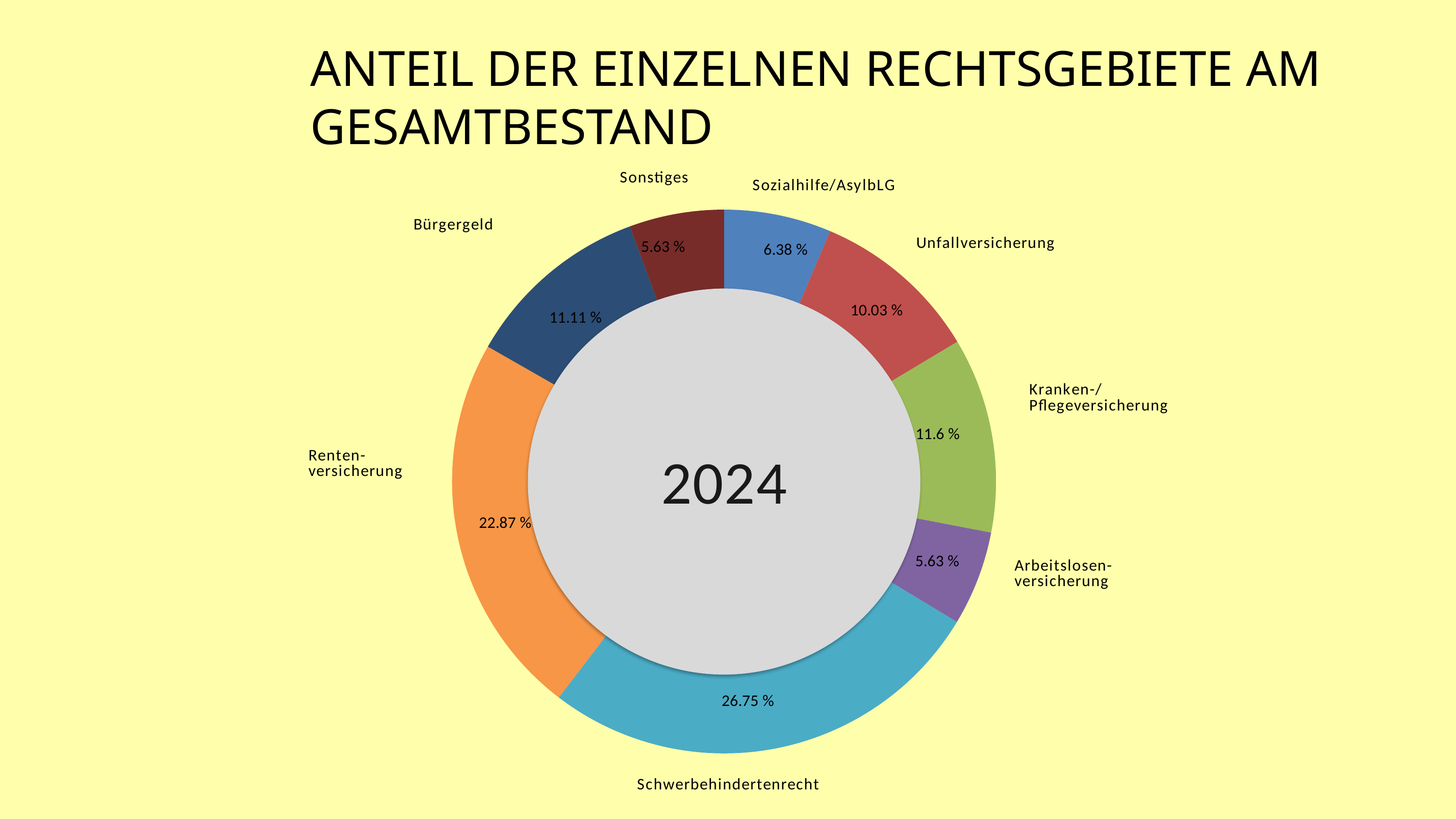
What share does Rentenversicherung have in the chart? 22.87 % What share does Kranken-/Pflegeversicherung have in the chart? 11.6 % What is the difference between the shares of Schwerbehindertenrecht and Rentenversicherung? 3.88 % What kind of chart is shown on the slide? Doughnut (pie) chart What share does Unfallversicherung have in the chart? 10.03 % Which has the larger share, Kranken-/Pflegeversicherung or Bürgergeld? Kranken-/Pflegeversicherung Which category has the largest share in the chart? Schwerbehindertenrecht What share does Sozialhilfe/AsylbLG have in the chart? 6.38 % Which has the larger share, Rentenversicherung or Unfallversicherung? Rentenversicherung What year is shown in the centre of the chart? 2024 How many categories are shown in the chart? 8 What share does Schwerbehindertenrecht have in the chart? 26.75 %